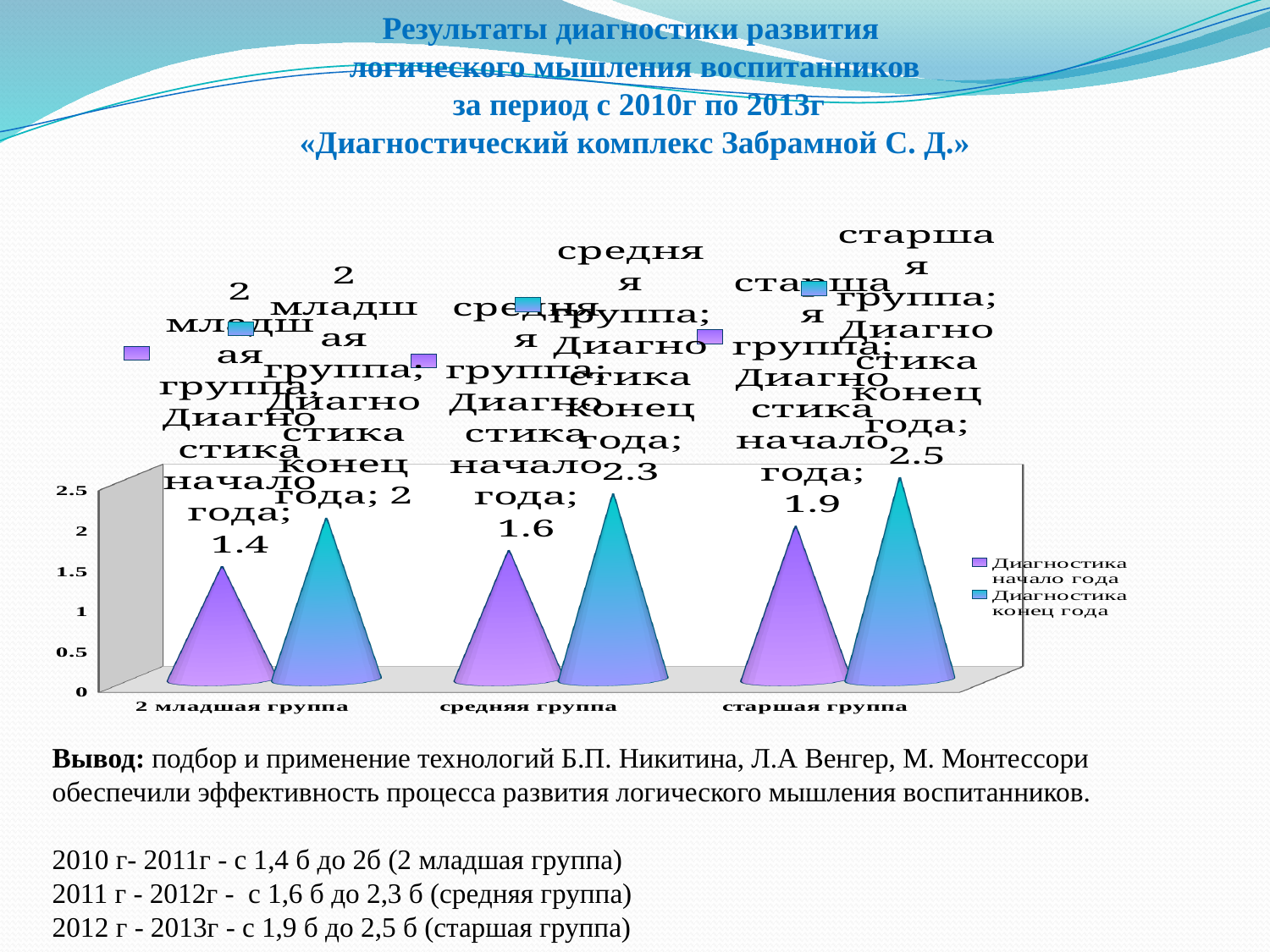
Which is larger for 'старшая группа': 'Диагностика начало года' or 'Диагностика конец года'? Диагностика конец года What is the value of 'Диагностика начало года' for '2 младшая группа'? 1.4 What is the value of 'Диагностика конец года' for 'средняя группа'? 2.3 What is the value of 'Диагностика начало года' for 'старшая группа'? 1.9 Does the value of 'Диагностика начало года' rise or fall from '2 младшая группа' to 'старшая группа'? rise Which group has the lowest value for 'Диагностика начало года'? 2 младшая группа What is the value of 'Диагностика конец года' for '2 младшая группа'? 2 Which group has the highest value for 'Диагностика конец года'? старшая группа How many groups (categories) are shown on the x axis? 3 What is the difference between 'Диагностика конец года' and 'Диагностика начало года' for 'средняя группа'? 0.7 How many series does the legend list? 2 What are the two series names listed in the legend? Диагностика начало года; Диагностика конец года